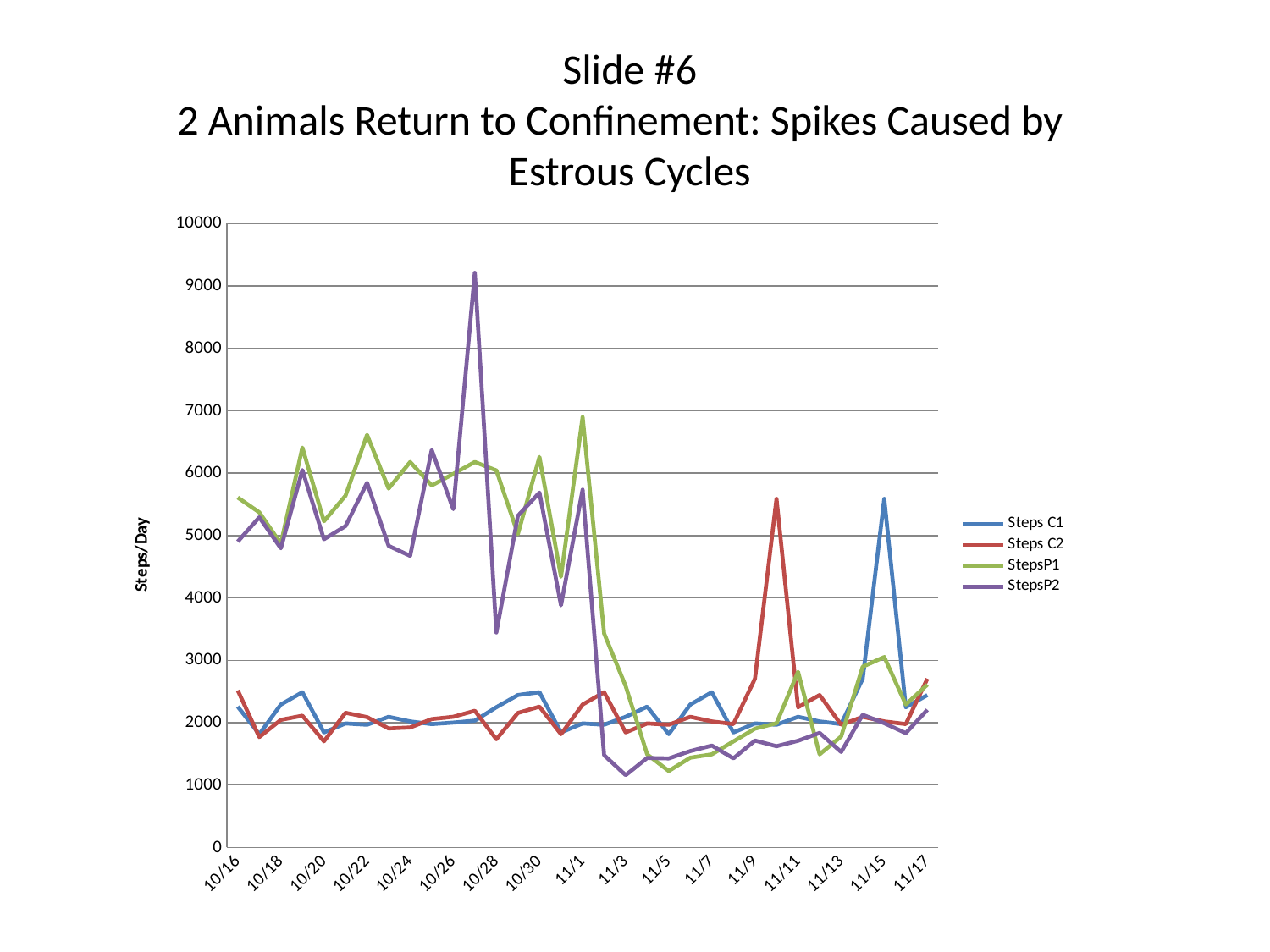
Is the peak value of Steps C1 around 11/15 greater or less than 5000? greater What kind of chart is shown on the slide? line chart Is the peak value of Steps C2 around 11/10 greater or less than 5000? greater Does the StepsP1 series rise or fall between 11/1 and 11/5? fall What are the four series named in the legend? Steps C1, Steps C2, StepsP1, StepsP2 How many series does the legend list? 4 What is the label on the vertical axis? Steps/Day Is the peak value of StepsP2 around 10/27 greater or less than 9000? greater Around 10/27, which series has the larger value, StepsP2 or StepsP1? StepsP2 Around 11/10, which series has the larger value, Steps C2 or Steps C1? Steps C2 Which series reaches the highest value anywhere on the chart? StepsP2